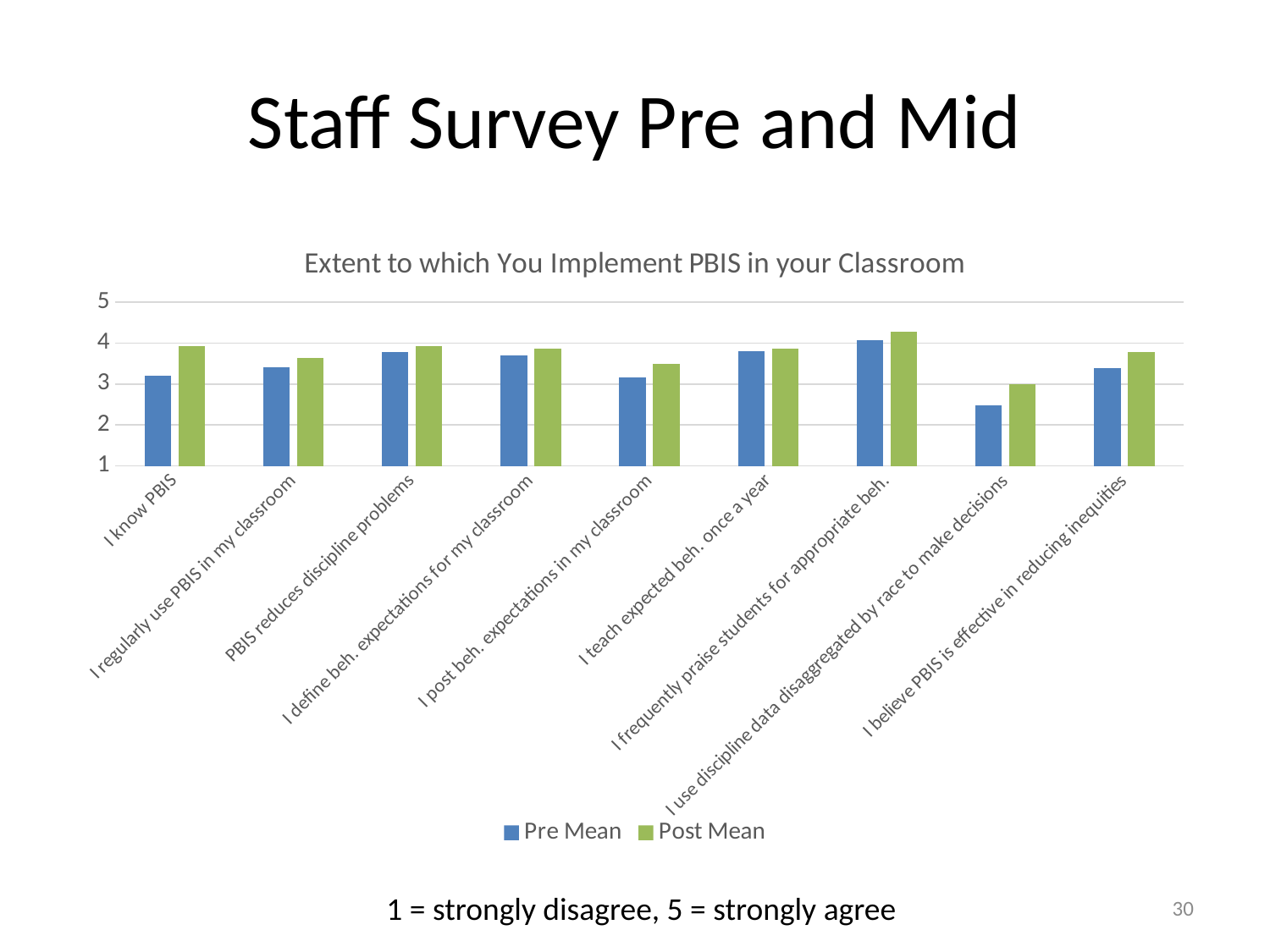
How many categories are shown on the x axis? 9 Which category has the lowest Post Mean value? I use discipline data disaggregated by race to make decisions Which category has the highest Post Mean value? I frequently praise students for appropriate beh. Which series is shown in green? Post Mean Which category has the lowest Pre Mean value? I use discipline data disaggregated by race to make decisions What kind of chart is shown on the slide? bar chart How many series does the legend list? 2 Is the Post Mean value for 'I post beh. expectations in my classroom' greater or less than 4? less What is the title of the chart? Extent to which You Implement PBIS in your Classroom Is the Post Mean value for 'I frequently praise students for appropriate beh.' greater or less than 4? greater For 'I know PBIS', which is larger, the Pre Mean or the Post Mean? Post Mean Is the Pre Mean value for 'I use discipline data disaggregated by race to make decisions' greater or less than 3? less